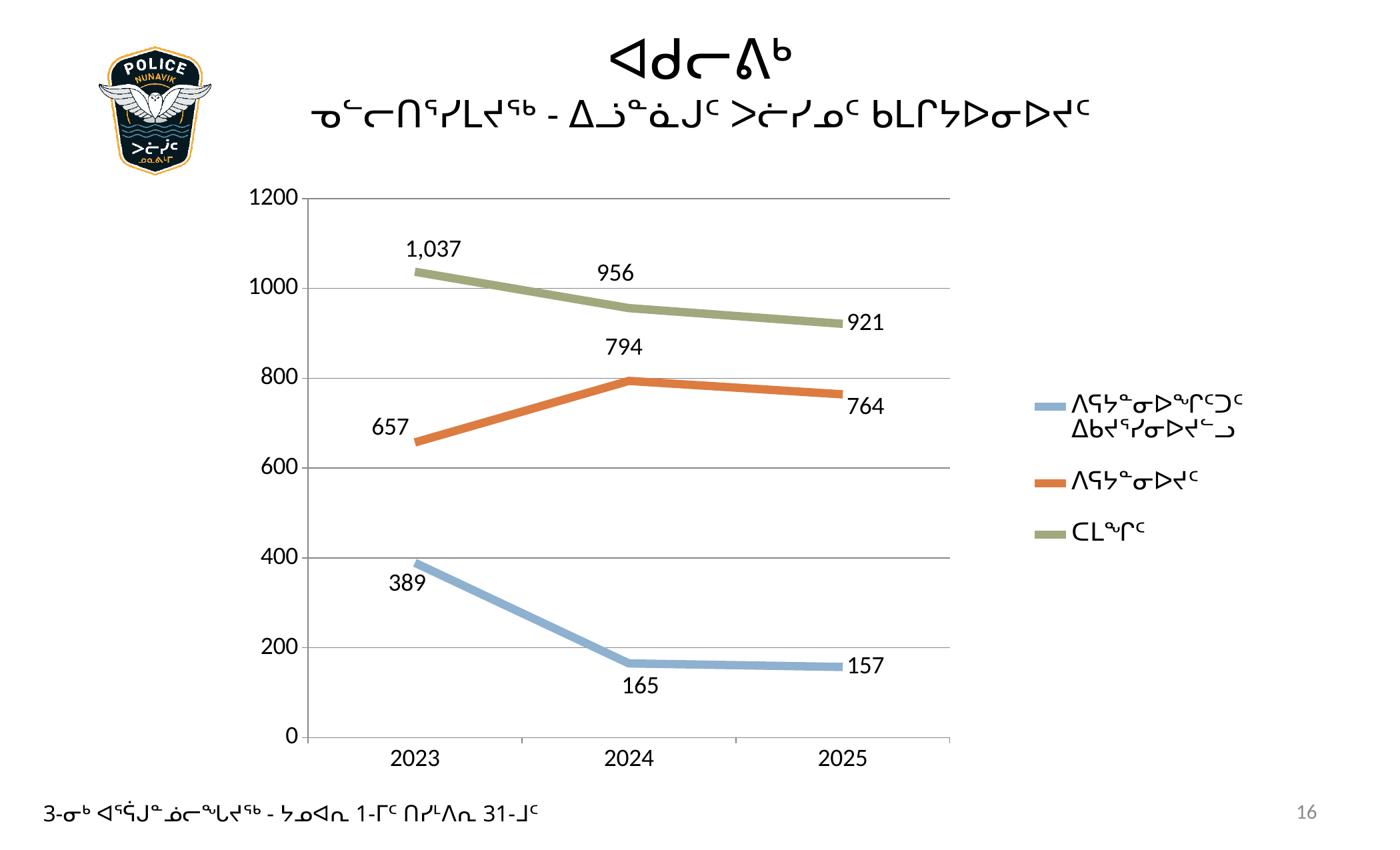
What is the value of the green line in 2023? 1,037 What is the difference between the blue line's values in 2023 and 2024? 224 What kind of chart is shown on the slide? line chart For the orange line, which year has the larger value, 2024 or 2025? 2024 How many series does the legend list? 3 Does the green line rise or fall from 2023 to 2025? fall What is the value of the blue line in 2025? 157 In which year is the blue line at its highest? 2023 How many years are shown on the x axis? 3 In which year is the green line at its lowest? 2025 What is the value of the orange line in 2024? 794 By how much did the green line fall from 2023 to 2025? 116